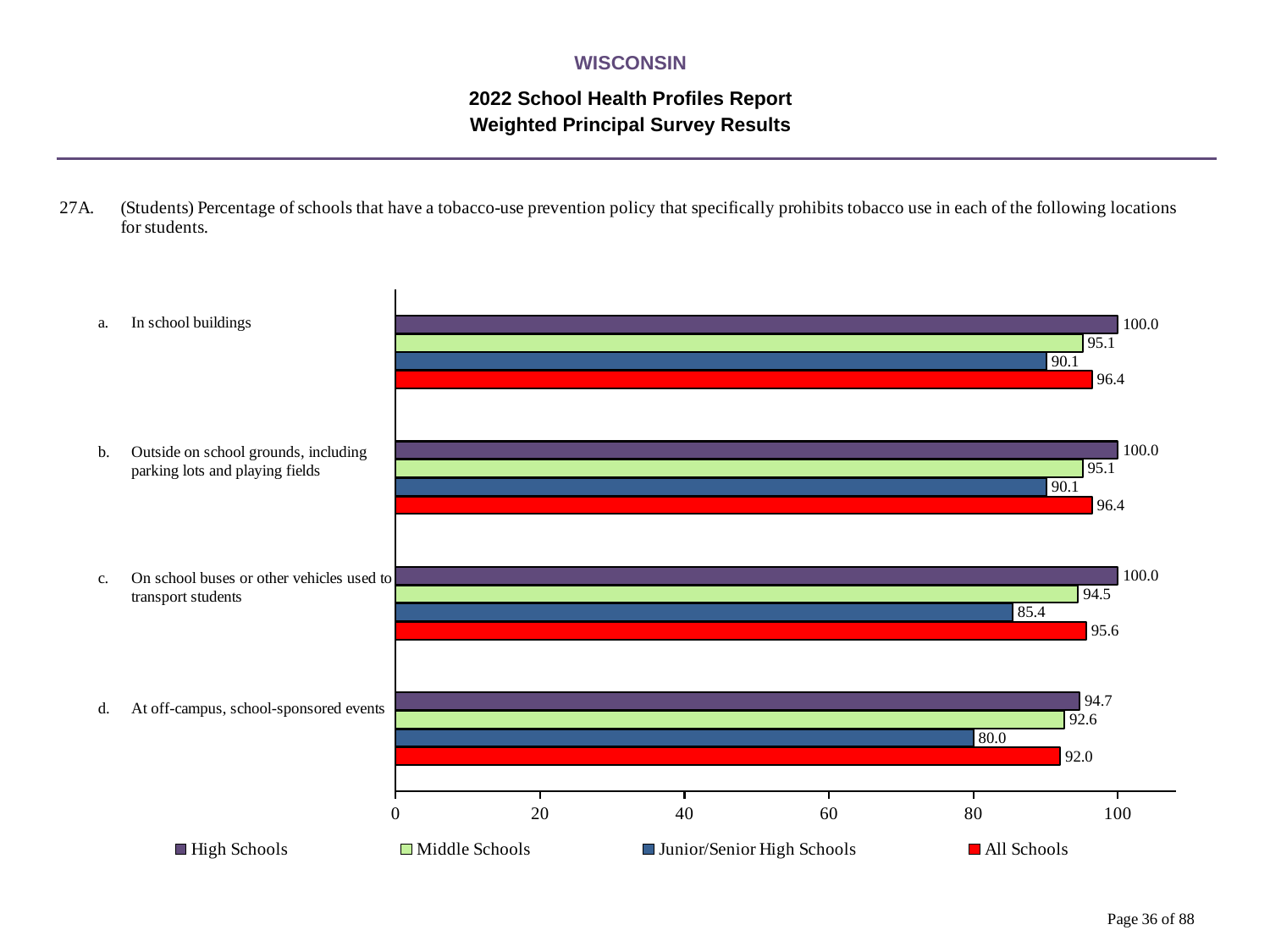
How many series does the legend list? 4 What kind of chart is shown on the slide? Bar chart What is the value for High Schools for 'In school buildings'? 100.0 What is the value for Junior/Senior High Schools for 'At off-campus, school-sponsored events'? 80.0 Which series has the lowest value for 'On school buses or other vehicles used to transport students'? Junior/Senior High Schools What is the difference between the High Schools and Junior/Senior High Schools values for 'At off-campus, school-sponsored events'? 14.7 What is the value for All Schools for 'On school buses or other vehicles used to transport students'? 95.6 How many locations (categories) are shown in the chart? 4 Which is larger for 'In school buildings': the Middle Schools value or the Junior/Senior High Schools value? Middle Schools Which colour represents All Schools in the chart? Red Which location has the lowest value for Junior/Senior High Schools? At off-campus, school-sponsored events What is the value for Middle Schools for 'Outside on school grounds, including parking lots and playing fields'? 95.1